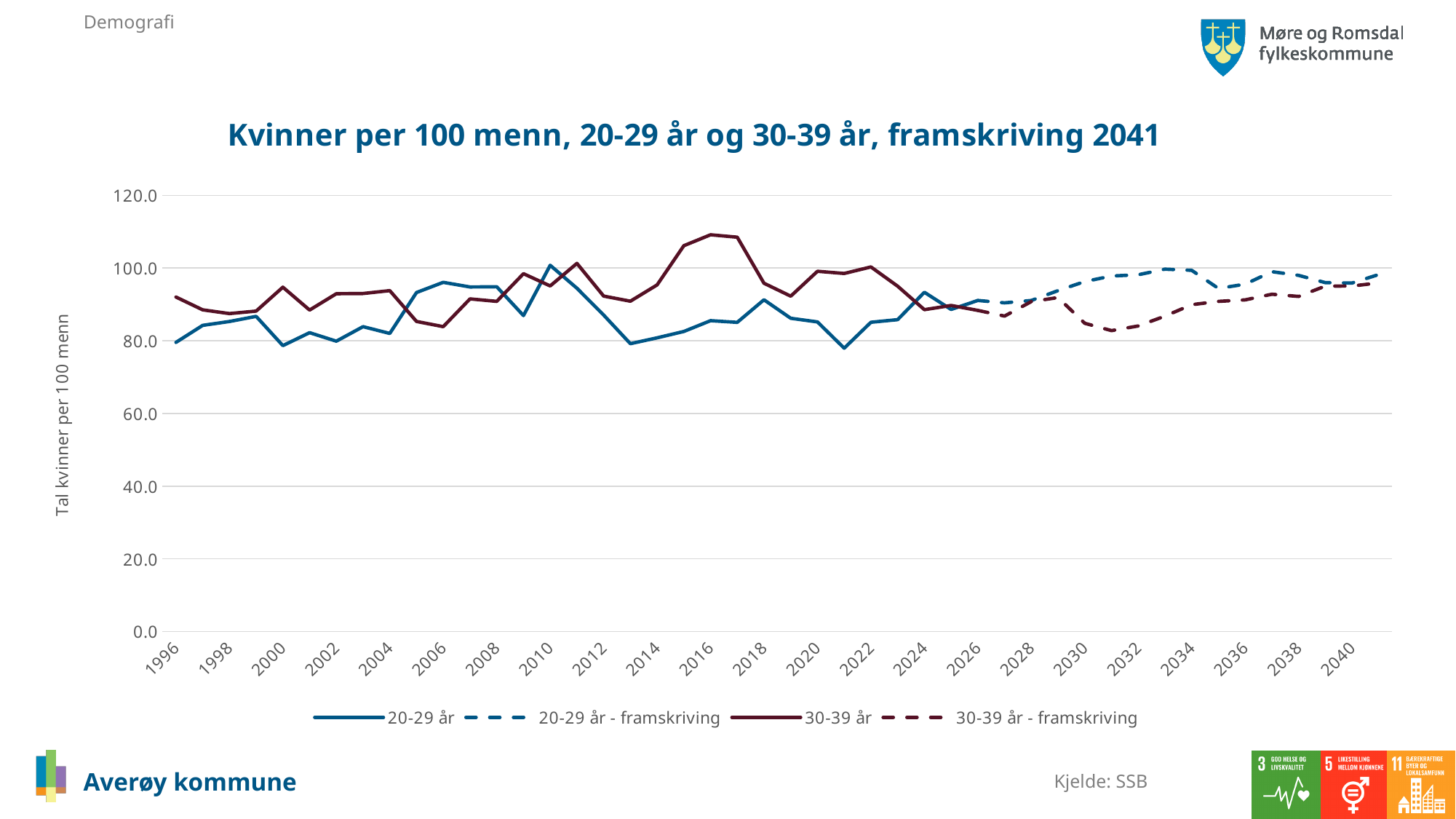
What is the label on the vertical axis? Tal kvinner per 100 menn Does the 30-39 år series rise or fall between 2014 and 2016? rise In 2016, which series has the higher value: 20-29 år or 30-39 år? 30-39 år Is the value for 20-29 år - framskriving in 2033 greater or less than 80? greater In 2031, which is higher: 20-29 år - framskriving or 30-39 år - framskriving? 20-29 år - framskriving How many series does the legend list? 4 What is the title of the chart? Kvinner per 100 menn, 20-29 år og 30-39 år, framskriving 2041 In 2010, which series has the higher value: 20-29 år or 30-39 år? 20-29 år Is the value for 30-39 år - framskriving in 2031 greater or less than 100? less Is the value for 20-29 år in 2000 greater or less than 100? less What kind of chart is shown on the slide? line chart